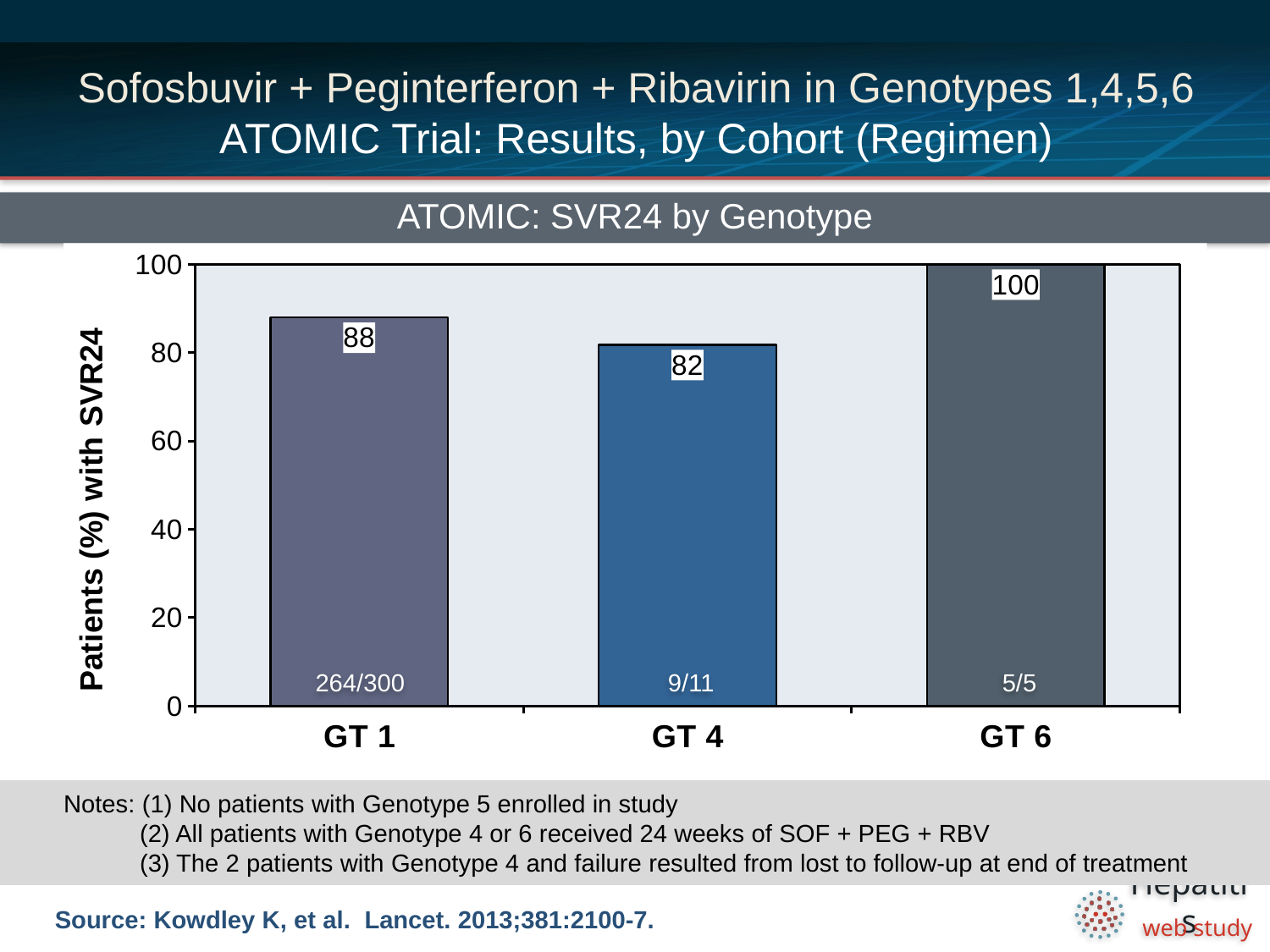
What is the difference in SVR24 rate between GT 1 and GT 4? 6 What is the difference in SVR24 rate between GT 6 and GT 4? 18 How many genotype categories are shown in the chart? 3 What is the SVR24 rate (%) for GT 6? 100 What fraction of patients is shown inside the GT 1 bar? 264/300 What is the title of the chart? ATOMIC: SVR24 by Genotype Which genotype has the highest SVR24 rate? GT 6 What is the SVR24 rate (%) for GT 4? 82 What is the SVR24 rate (%) for GT 1? 88 Which has a higher SVR24 rate, GT 1 or GT 4? GT 1 Which genotype has the lowest SVR24 rate? GT 4 What type of chart is shown on the slide? Bar chart